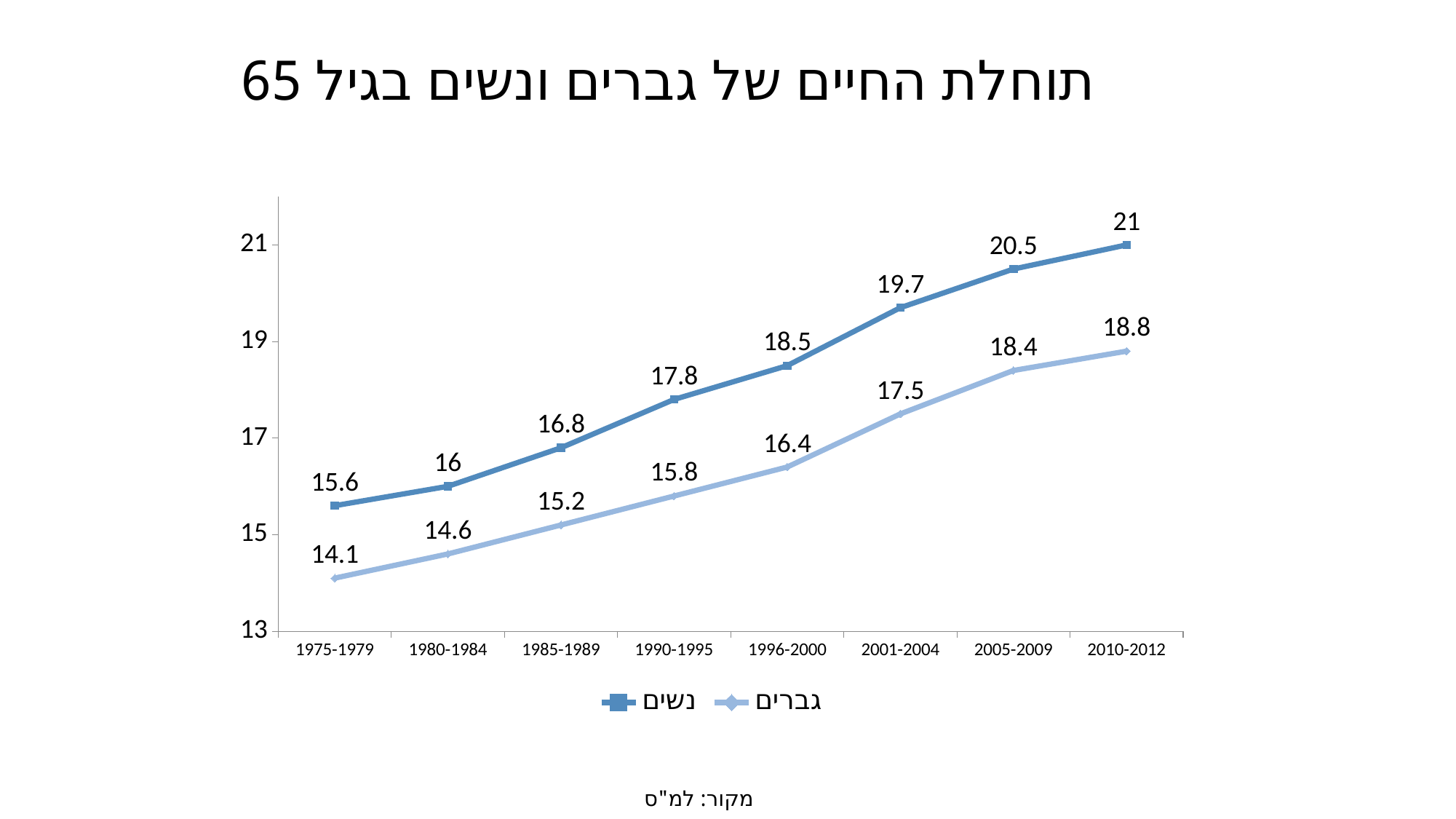
In which period is the value for גברים (men) lowest? 1975-1979 What is the value for נשים (women) in 1975-1979? 15.6 Which is larger in 1990-1995: the value for נשים (women) or for גברים (men)? נשים (women) What is the difference between נשים (women) and גברים (men) in 2010-2012? 2.2 What kind of chart is shown on the slide? Line chart In which period is the value for נשים (women) highest? 2010-2012 Do the values for גברים (men) rise or fall from 1975-1979 to 2010-2012? Rise How many series does the legend list? 2 How many periods are shown on the x axis? 8 What is the value for נשים (women) in 2001-2004? 19.7 What is the value for גברים (men) in 1996-2000? 16.4 What is the value for גברים (men) in 2010-2012? 18.8